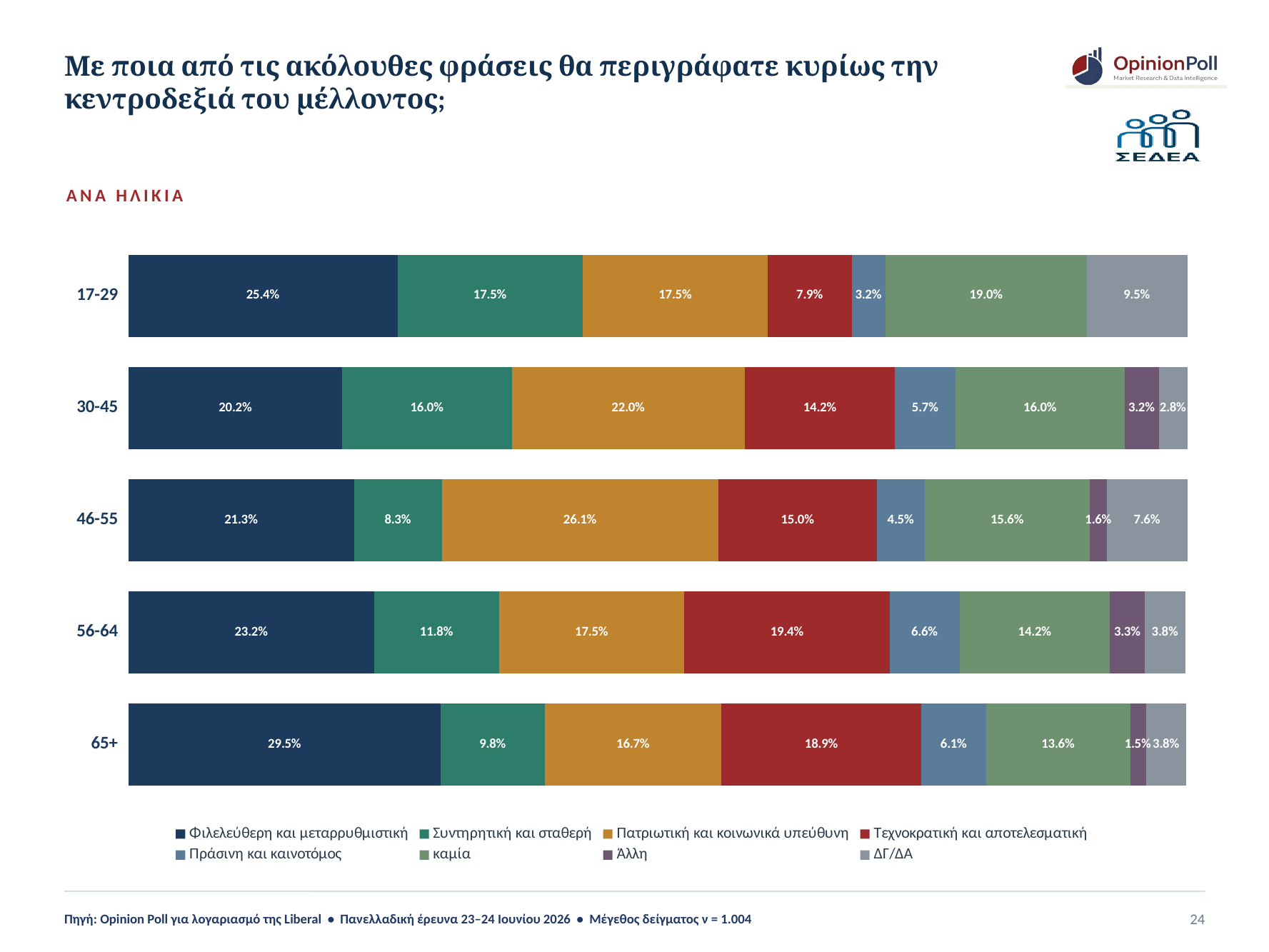
Which age group has the highest value for «Φιλελεύθερη και μεταρρυθμιστική»? 65+ What is the «ΔΓ/ΔΑ» value for the 17-29 age group? 9.5% In the 30-45 age group, which is larger: «Πατριωτική και κοινωνικά υπεύθυνη» or «Συντηρητική και σταθερή»? Πατριωτική και κοινωνικά υπεύθυνη In the 17-29 age group, what is the difference between «Φιλελεύθερη και μεταρρυθμιστική» and «Τεχνοκρατική και αποτελεσματική»? 17.5 percentage points What colour represents «Τεχνοκρατική και αποτελεσματική» in the chart? Red Which age group has the lowest value for «Συντηρητική και σταθερή»? 46-55 What kind of chart is shown on the slide? Stacked bar chart How many series does the legend list? 8 How many age groups are shown in the chart? 5 What is the value for «Πατριωτική και κοινωνικά υπεύθυνη» in the 46-55 age group? 26.1% What percentage of the 65+ age group chose «Φιλελεύθερη και μεταρρυθμιστική»? 29.5% Which age group has the highest value for «Τεχνοκρατική και αποτελεσματική»? 56-64